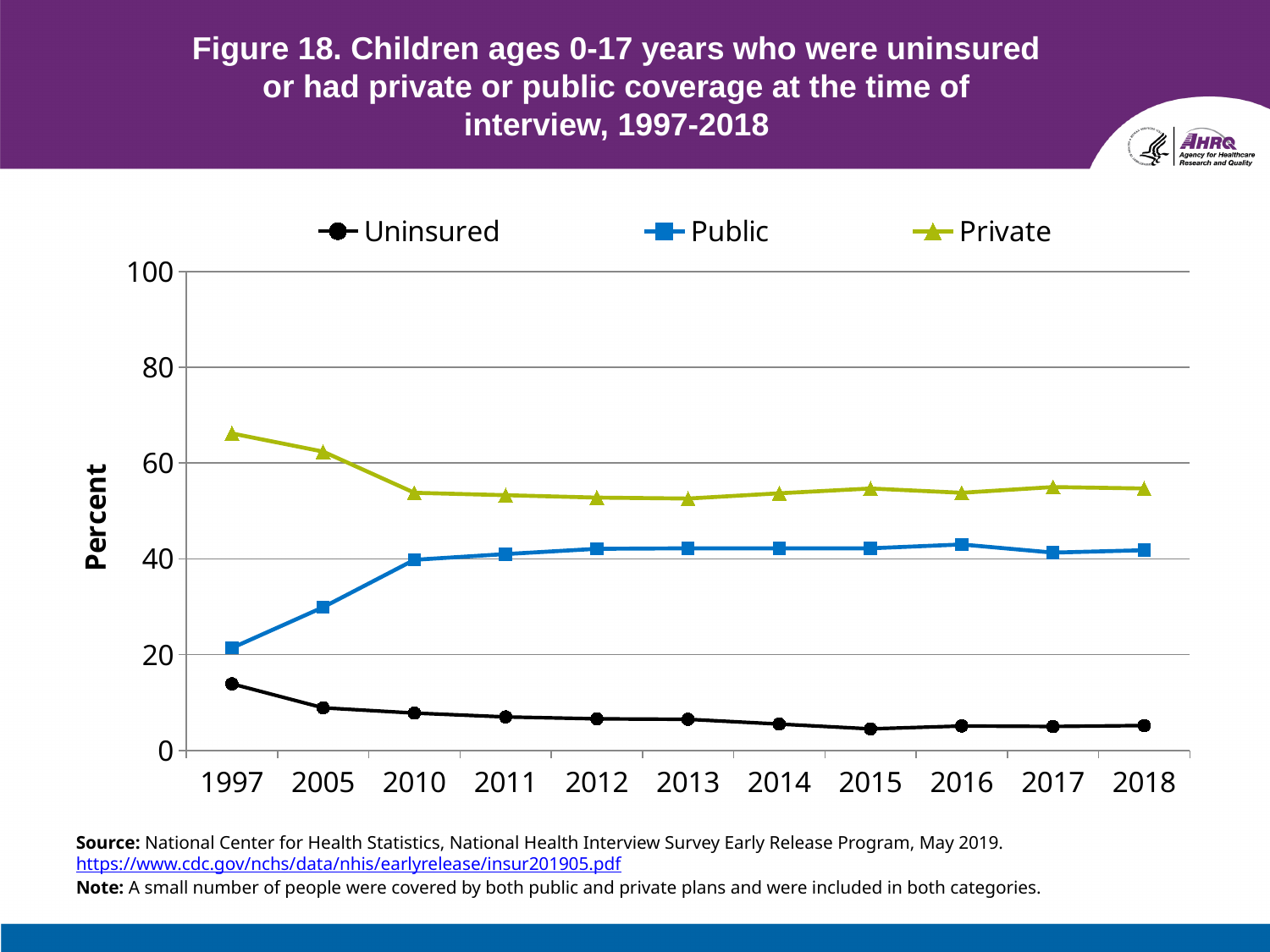
How many series does the legend list? 3 How many years are plotted along the x axis? 11 What is the label on the y axis? Percent In which year was the Uninsured series at its highest? 1997 In which year was the Private series at its highest? 1997 Is the value for Private in 1997 greater or less than 60? greater Is the value for Public in 2005 greater or less than 40? less Which series has the larger value in 2018, Public or Private? Private Does the Public series rise or fall between 1997 and 2010? rise Is the value for Uninsured in 2018 greater or less than 20? less What kind of chart is shown on the slide? line chart In which year was the Public series at its lowest? 1997